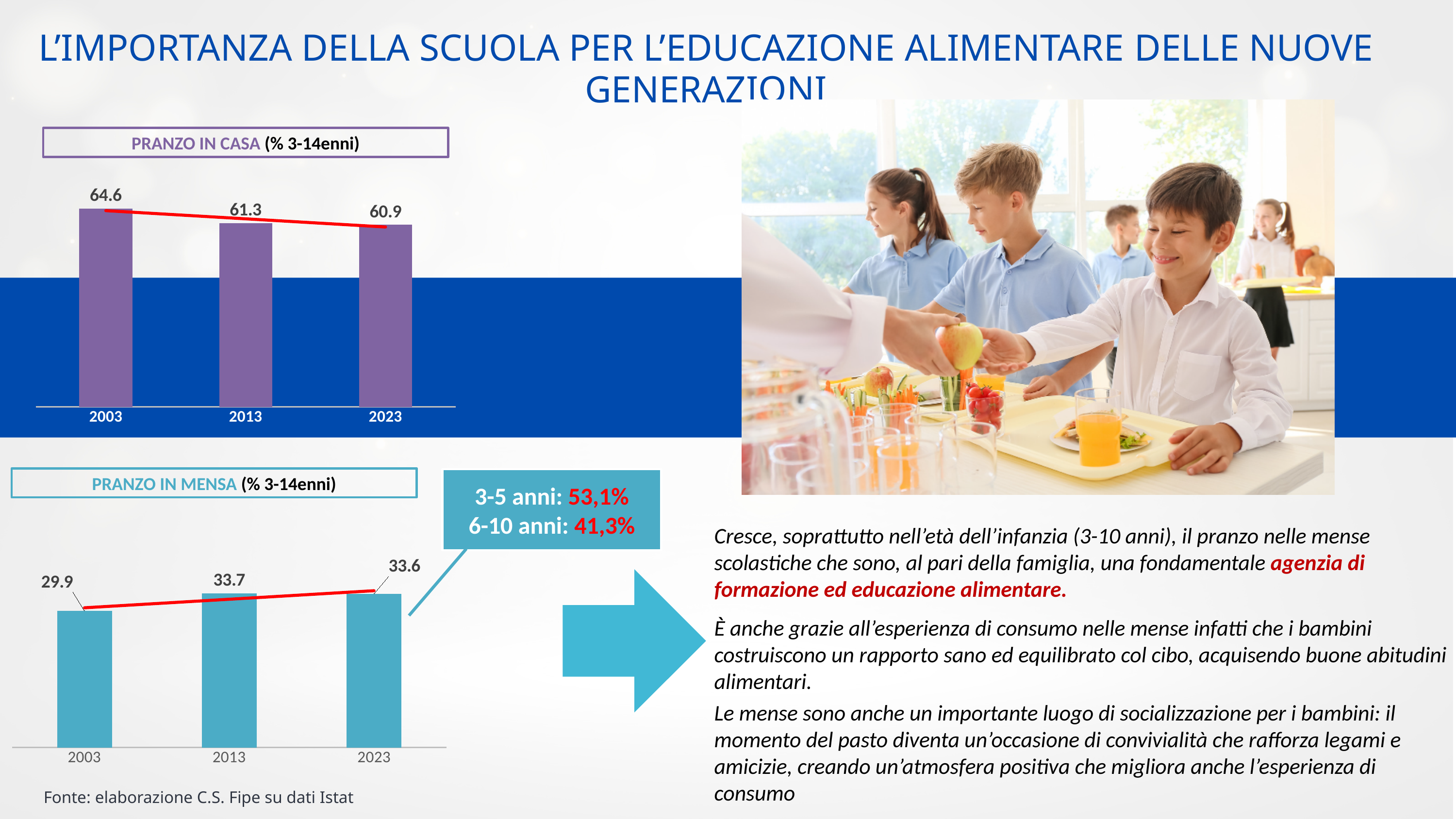
In the 'PRANZO IN MENSA' chart, what is the value for 2013? 33.7 In the 'PRANZO IN CASA' chart, which year has the highest value? 2003 In the 'PRANZO IN CASA' chart, do the values rise or fall from 2003 to 2023? Fall In the 'PRANZO IN MENSA' chart, which is larger, the value for 2003 or the value for 2023? 2023 In the 'PRANZO IN MENSA' chart, what is the difference between the 2013 and 2003 values? 3.8 What kind of chart is the 'PRANZO IN MENSA' chart? Bar chart In the 'PRANZO IN MENSA' chart, which year has the lowest value? 2003 In the 'PRANZO IN MENSA' chart, what is the value for 2003? 29.9 In the 'PRANZO IN CASA' chart, what is the value for 2003? 64.6 How many years are shown in the 'PRANZO IN CASA' chart? 3 In the 'PRANZO IN CASA' chart, what is the difference between the 2003 and 2023 values? 3.7 In the 'PRANZO IN CASA' chart, what is the value for 2023? 60.9